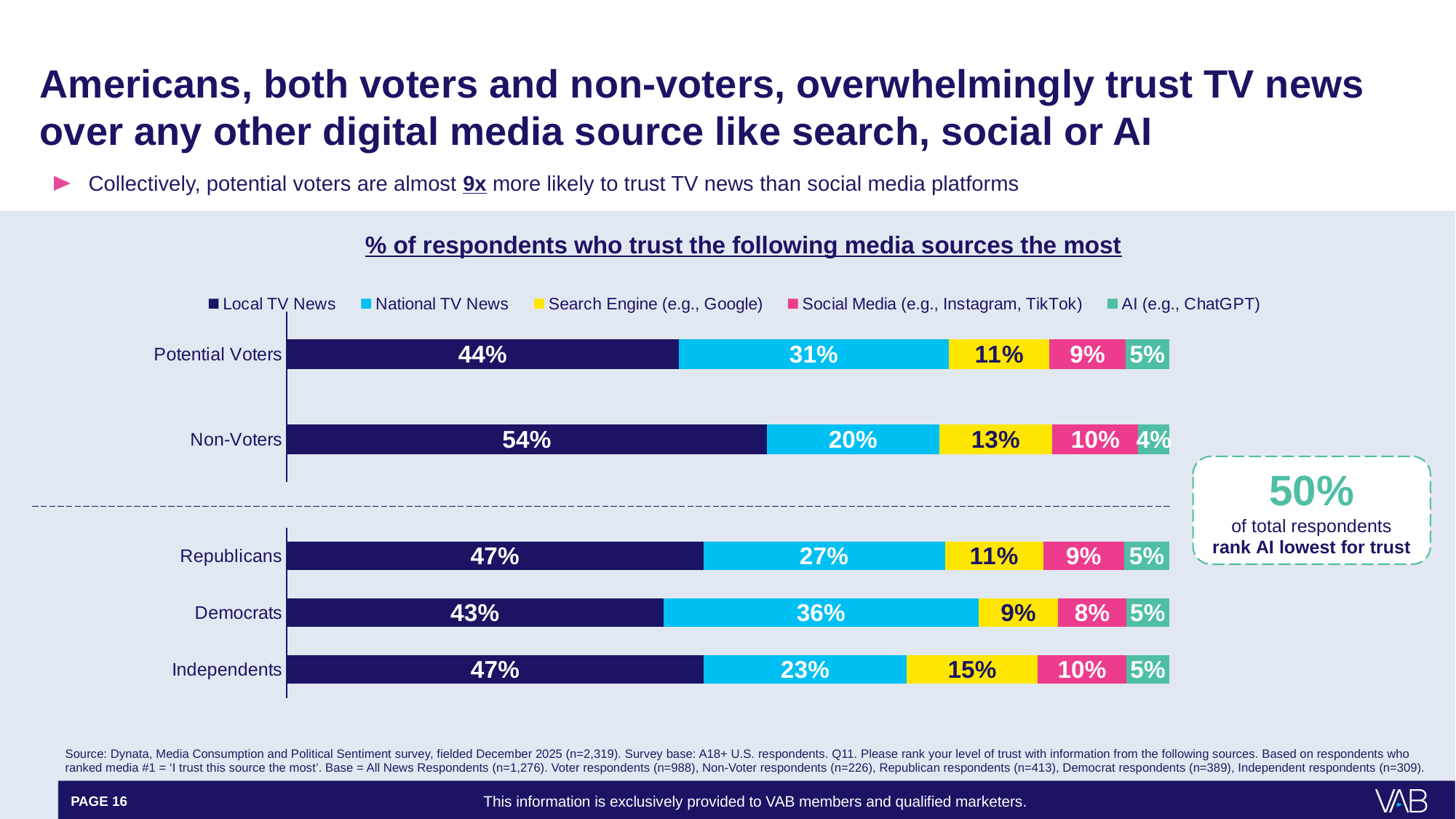
What percentage of Non-Voters trust Local TV News the most? 54% What type of chart is shown on the slide? Stacked bar chart Which group has the lowest National TV News value? Non-Voters What is the title of the chart? % of respondents who trust the following media sources the most What is the AI (e.g., ChatGPT) value for Non-Voters? 4% What percentage of Democrats trust National TV News the most? 36% Which group has the highest Local TV News value? Non-Voters What is the Search Engine (e.g., Google) value for Independents? 15% Which group has the larger Social Media value, Republicans or Independents? Independents How many respondent groups are shown in the chart? 5 How many media sources does the legend list? 5 How many percentage points higher is the Local TV News value for Non-Voters than for Potential Voters? 10 percentage points